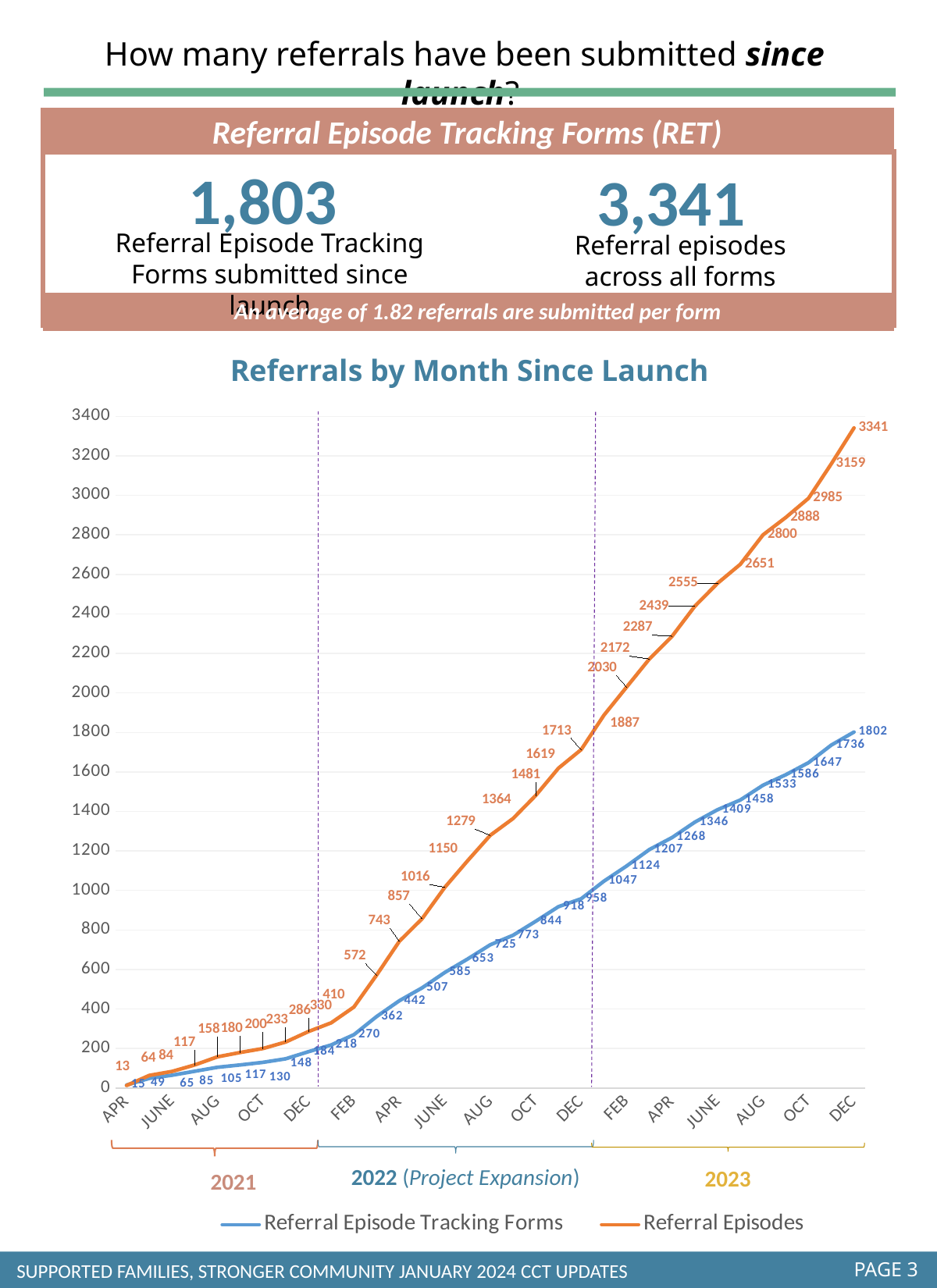
In the 'Referrals by Month Since Launch' chart, which series is higher at DEC 2023: Referral Episodes or Referral Episode Tracking Forms? Referral Episodes In the 'Referrals by Month Since Launch' chart, what colour is the Referral Episodes line? orange In the 'Referrals by Month Since Launch' chart, what is the final value of the Referral Episodes series at DEC 2023? 3341 What type of chart is 'Referrals by Month Since Launch'? line chart In the 'Referrals by Month Since Launch' chart, is the Referral Episode Tracking Forms value at DEC 2022 greater or less than 1000? less How many series does the legend of the 'Referrals by Month Since Launch' chart list? 2 What is the title of the line chart on the slide? Referrals by Month Since Launch In the 'Referrals by Month Since Launch' chart, what is the first value of the Referral Episodes series at APR 2021? 13 In the 'Referrals by Month Since Launch' chart, do the values rise or fall from APR 2021 to DEC 2023? rise In the 'Referrals by Month Since Launch' chart, what is the highest value reached by the Referral Episodes series? 3341 In the 'Referrals by Month Since Launch' chart, what is the final value of the Referral Episode Tracking Forms series at DEC 2023? 1802 In the 'Referrals by Month Since Launch' chart, what is the difference between the final Referral Episodes value (3341) and the final Referral Episode Tracking Forms value (1802)? 1539